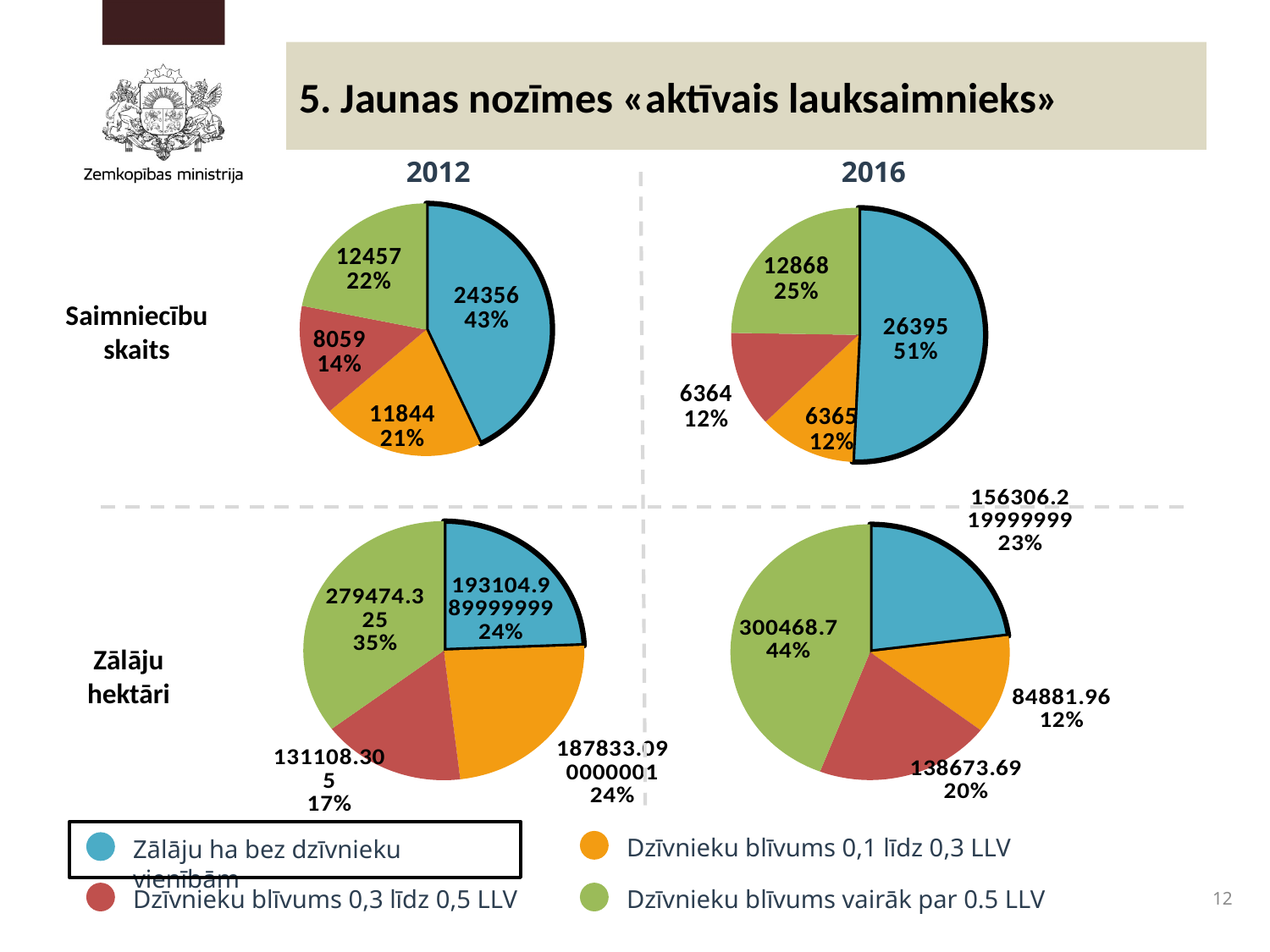
In the 2012 Saimniecību skaits pie chart (top left), what is the difference between the values for Zālāju ha bez dzīvnieku vienībām and Dzīvnieku blīvums 0,1 līdz 0,3 LLV? 12512 In the 2016 Zālāju hektāri pie chart (bottom right), what is the value for Dzīvnieku blīvums 0,1 līdz 0,3 LLV? 84881.96 In the 2016 Zālāju hektāri pie chart (bottom right), which is larger: the slice for Dzīvnieku blīvums 0,3 līdz 0,5 LLV or the slice for Dzīvnieku blīvums 0,1 līdz 0,3 LLV? Dzīvnieku blīvums 0,3 līdz 0,5 LLV In the 2012 Saimniecību skaits pie chart (top left), what is the value for Zālāju ha bez dzīvnieku vienībām? 24356 In the 2016 Saimniecību skaits pie chart (top right), which category has the largest slice? Zālāju ha bez dzīvnieku vienībām In the 2016 Saimniecību skaits pie chart (top right), what is the value for Dzīvnieku blīvums vairāk par 0.5 LLV? 12868 In the 2012 Saimniecību skaits pie chart (top left), what share does Dzīvnieku blīvums 0,3 līdz 0,5 LLV have? 14% In the 2012 Zālāju hektāri pie chart (bottom left), which category has the largest slice? Dzīvnieku blīvums vairāk par 0.5 LLV In the 2012 Saimniecību skaits pie chart (top left), which category has the smallest slice? Dzīvnieku blīvums 0,3 līdz 0,5 LLV How many pie charts are shown on the slide? 4 In the 2016 Zālāju hektāri pie chart (bottom right), what share does Dzīvnieku blīvums vairāk par 0.5 LLV have? 44% How many categories does the legend at the bottom of the slide list? 4